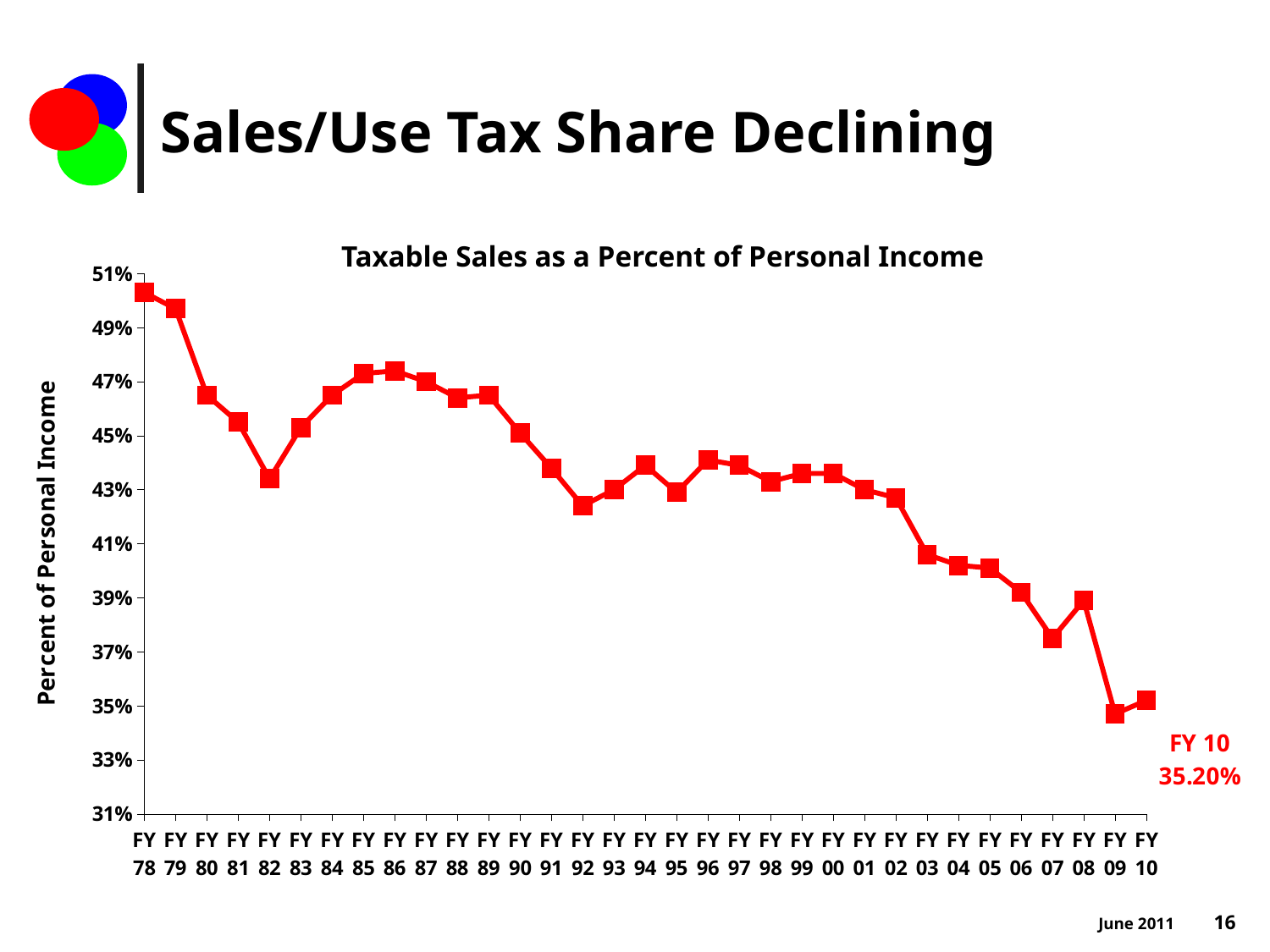
What is the title of the chart? Taxable Sales as a Percent of Personal Income What value is labelled for FY 10? 35.20% Is the value for FY 82 greater or less than 45%? less What is the label on the vertical axis? Percent of Personal Income How many fiscal years are plotted on the chart? 33 Overall, do the values rise or fall from FY 78 to FY 10? fall Is the value for FY 07 greater or less than 39%? less Which is larger, the value for FY 96 or the value for FY 02? FY 96 Is the value for FY 79 greater or less than 49%? greater What kind of chart is shown on the slide? line chart Which fiscal year has the highest value? FY 78 Which fiscal year has the lowest value? FY 09